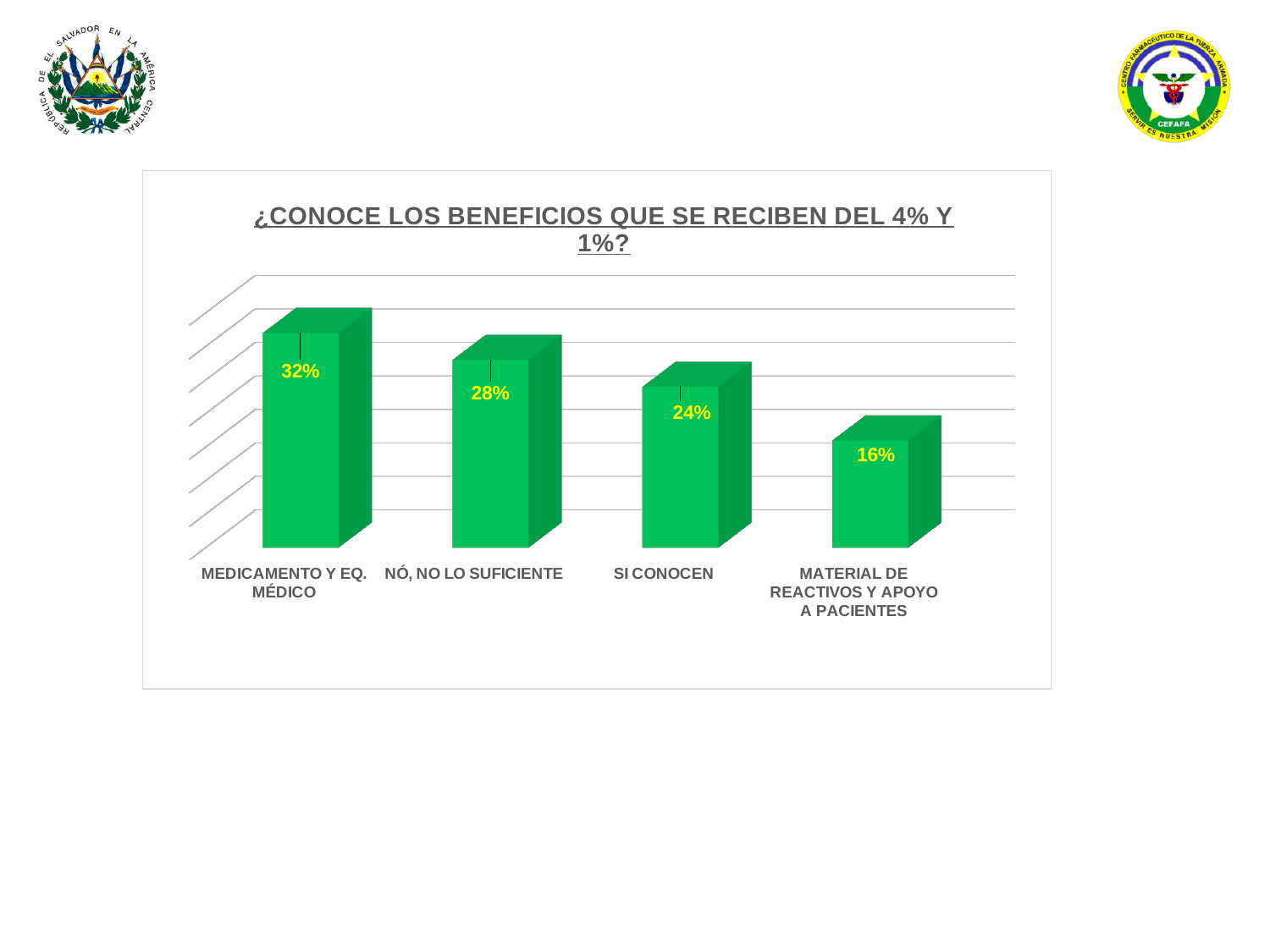
Do the values rise or fall from left to right along the x axis? fall What is the difference between the values for MEDICAMENTO Y EQ. MÉDICO and MATERIAL DE REACTIVOS Y APOYO A PACIENTES? 16% What is the value for NÓ, NO LO SUFICIENTE? 28% How many categories are shown in the chart? 4 What is the difference between the values for NÓ, NO LO SUFICIENTE and SI CONOCEN? 4% Which category has the lowest value? MATERIAL DE REACTIVOS Y APOYO A PACIENTES What is the value for MATERIAL DE REACTIVOS Y APOYO A PACIENTES? 16% Which is larger, the value for SI CONOCEN or the value for MATERIAL DE REACTIVOS Y APOYO A PACIENTES? SI CONOCEN What is the value for SI CONOCEN? 24% What is the value for MEDICAMENTO Y EQ. MÉDICO? 32% What kind of chart is shown on the slide? bar chart Which category has the highest value? MEDICAMENTO Y EQ. MÉDICO